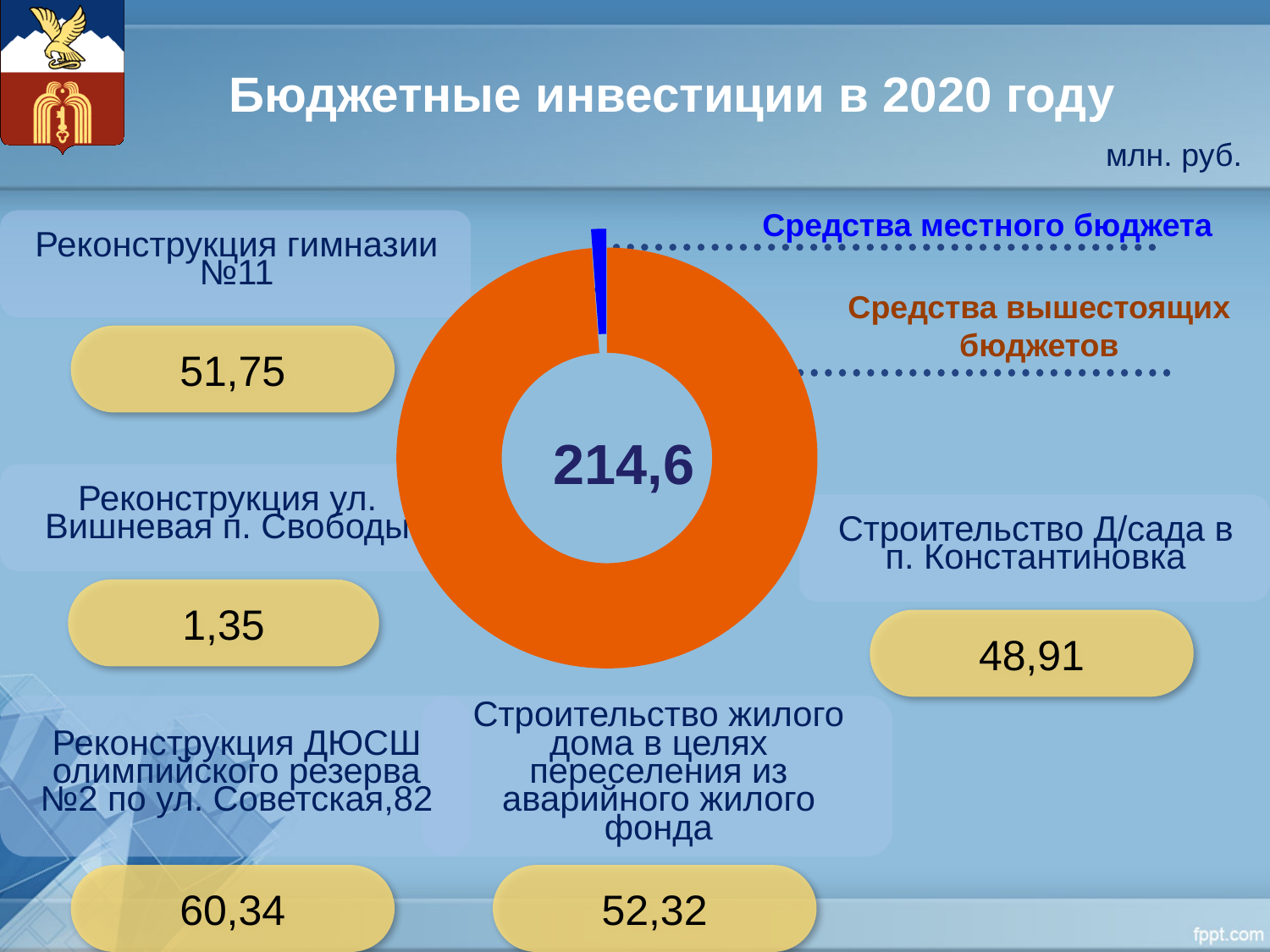
What is the difference between the values shown for Реконструкция ДЮСШ олимпийского резерва №2 по ул. Советская,82 and Реконструкция ул. Вишневая п. Свободы? 58,99 Which segment of the donut chart is larger: Средства местного бюджета or Средства вышестоящих бюджетов? Средства вышестоящих бюджетов What value is shown on the slide for Строительство Д/сада в п. Константиновка? 48,91 Which segment of the donut chart is the smallest? Средства местного бюджета Which segment of the donut chart is the largest? Средства вышестоящих бюджетов What total value is printed in the centre of the donut chart? 214,6 What is the title of the slide containing the donut chart? Бюджетные инвестиции в 2020 году What colour is the Средства местного бюджета segment of the donut chart? blue What value is shown on the slide for Реконструкция гимназии №11? 51,75 What kind of chart is shown on the slide? pie chart (donut) How many segments does the donut chart have? 2